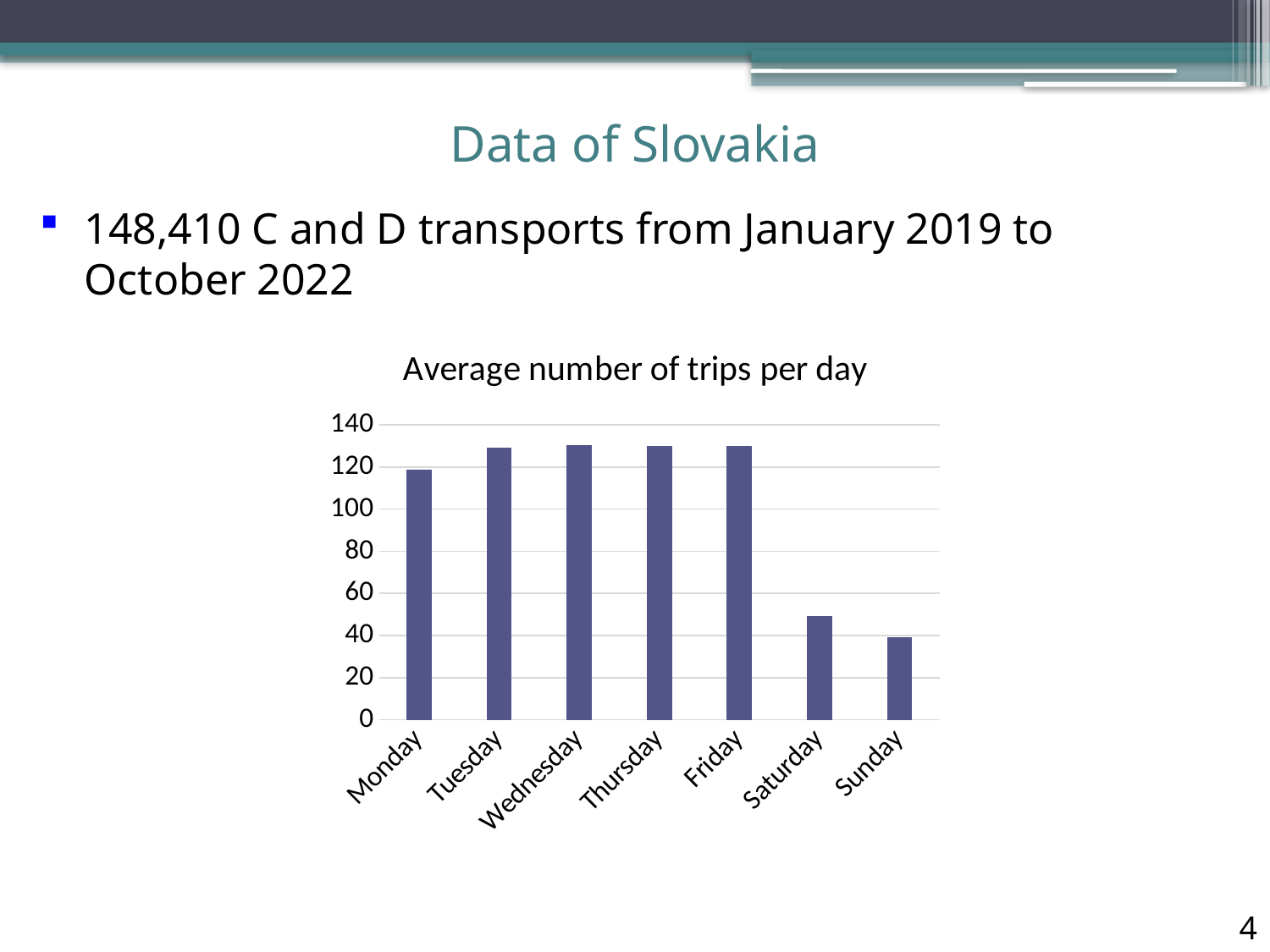
Which is larger, the value for Saturday or the value for Sunday? Saturday Which is larger, the value for Monday or the value for Tuesday? Tuesday Do the values rise or fall from Friday to Sunday? fall Is the value for Tuesday greater or less than 120? greater Is the value for Wednesday greater or less than 140? less Which day has the lowest average number of trips? Sunday Is the value for Sunday greater or less than 60? less What is the title of the chart? Average number of trips per day What kind of chart is shown on the slide? bar chart How many days are shown on the x axis of the chart? 7